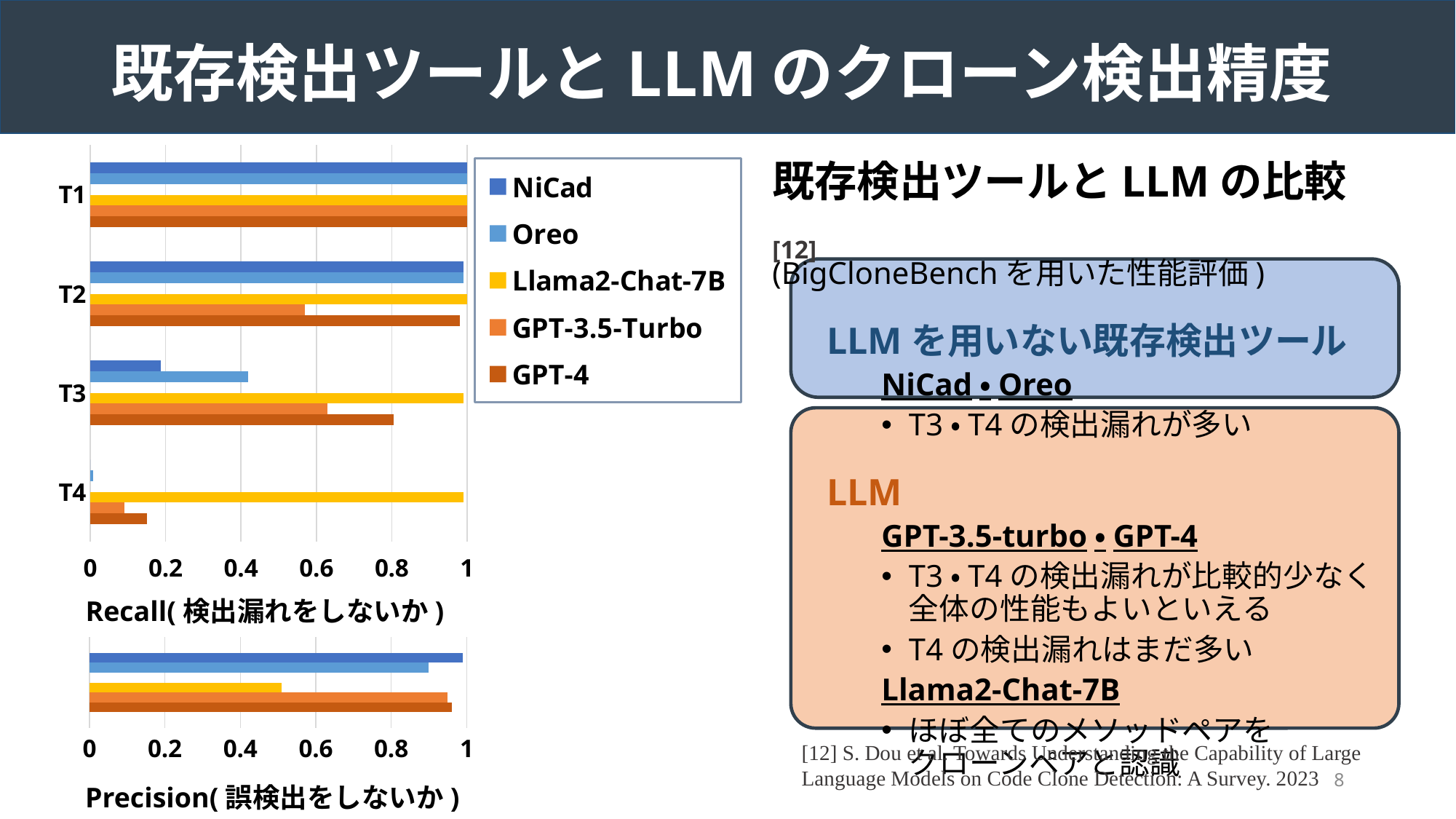
What kind of chart is the Recall chart on the left of the slide? bar chart In the Recall chart, is the value for GPT-4 at T4 greater or less than 0.4? less In the Recall chart, is the value for Llama2-Chat-7B at T4 greater or less than 0.8? greater How many series does the legend list for the charts on the slide? 5 In the Recall chart, is the value for GPT-3.5-Turbo at T2 greater or less than 0.8? less In the Recall chart, which series has the highest value for T3? Llama2-Chat-7B In the Recall chart, which is larger at T3: GPT-4 or GPT-3.5-Turbo? GPT-4 In the Precision chart, which series has the lowest value? Llama2-Chat-7B In the Recall chart, how many categories (T1–T4) are shown on the vertical axis? 4